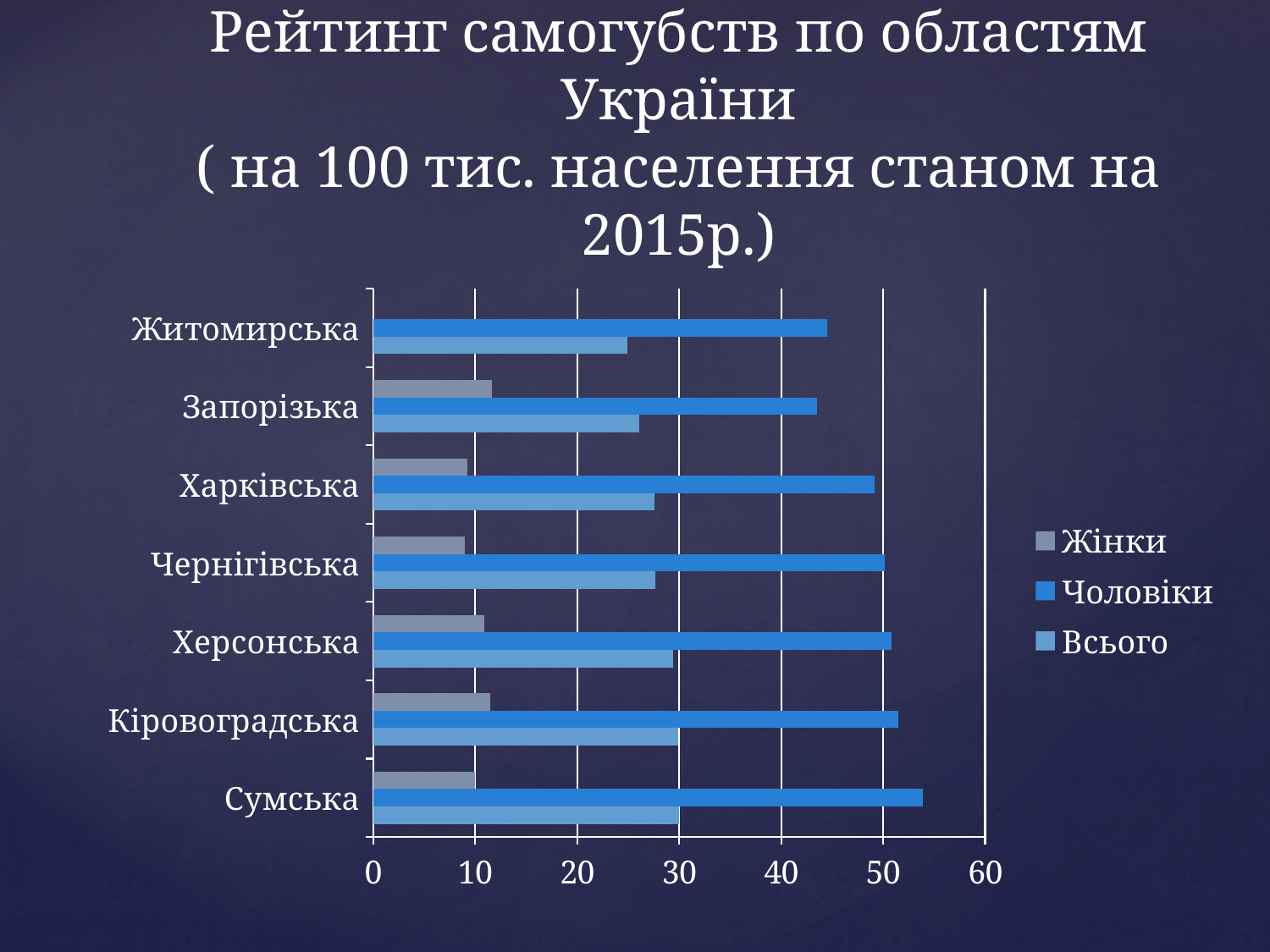
Which is larger for Харківська: the Чоловіки value or the Всього value? Чоловіки How many series does the legend list? 3 What kind of chart is shown on the slide? bar chart Which series is shown in the darkest blue colour in the legend? Чоловіки Which is larger: the Чоловіки value for Сумська or the Чоловіки value for Запорізька? Сумська Is the Жінки value for Чернігівська greater or less than 10? less What is the maximum value shown on the horizontal axis? 60 Is the Чоловіки value for Сумська greater or less than 50? greater Is the Чоловіки value for Житомирська greater or less than 50? less How many regions (categories) are shown on the chart? 7 Which region has the highest value for the Чоловіки series? Сумська